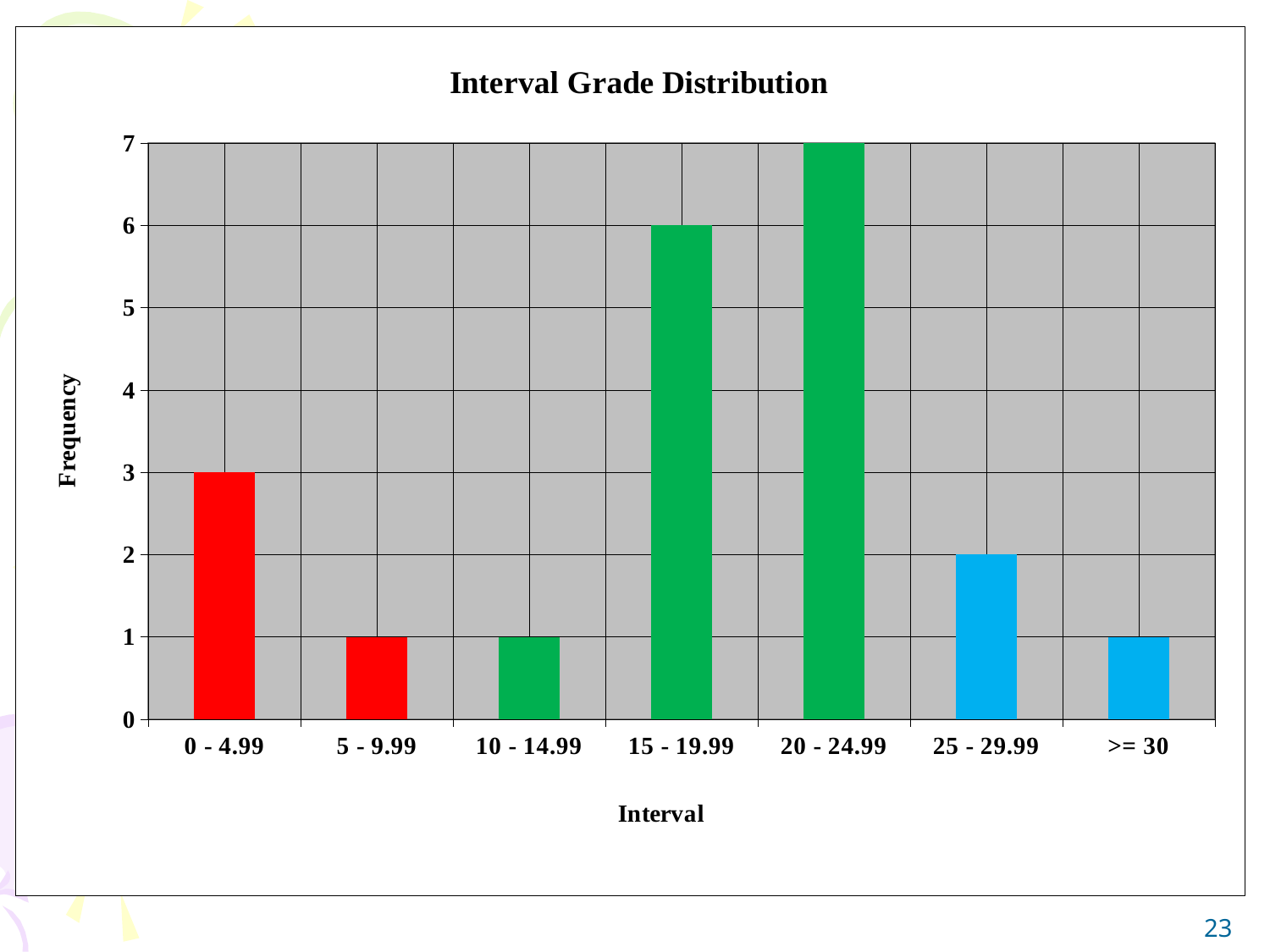
What type of chart is shown on the slide? bar chart Is the frequency for the 15 - 19.99 interval greater or less than 5? greater What is the frequency for the 15 - 19.99 interval? 6 What is the frequency for the 20 - 24.99 interval? 7 What is the frequency for the 25 - 29.99 interval? 2 What is the frequency for the 0 - 4.99 interval? 3 What is the difference in frequency between the 20 - 24.99 and 15 - 19.99 intervals? 1 How many intervals are shown on the x axis? 7 Which has a higher frequency, the 0 - 4.99 interval or the 25 - 29.99 interval? 0 - 4.99 What is the difference in frequency between the 0 - 4.99 and 25 - 29.99 intervals? 1 Which interval has the highest frequency? 20 - 24.99 What is the title of the chart? Interval Grade Distribution